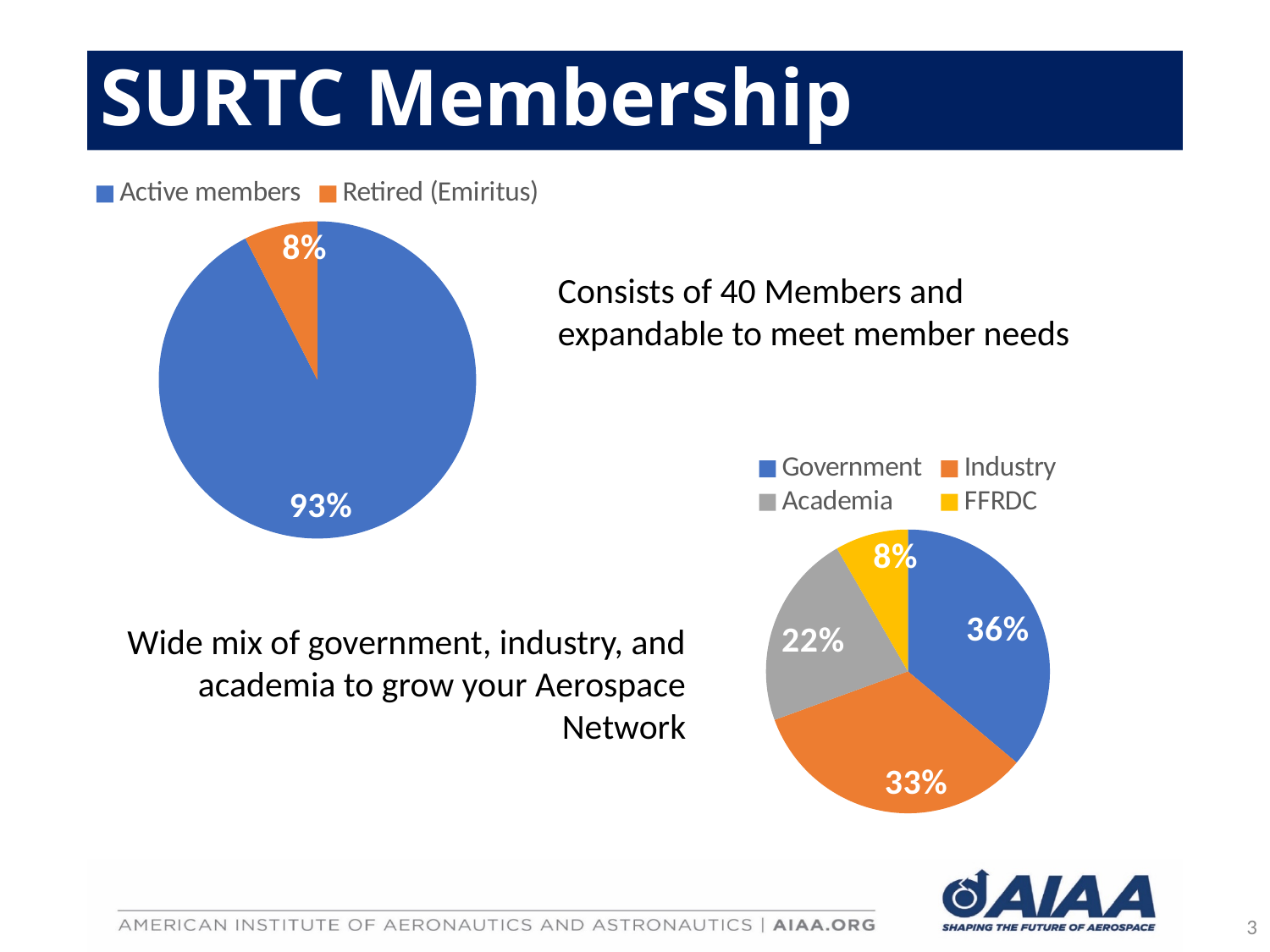
In the lower-right pie chart, what share is labelled for Industry? 33% What kind of chart is the chart in the upper left of the slide? pie chart In the lower-right pie chart, what colour is the FFRDC slice? yellow In the lower-right pie chart, what share is labelled for Academia? 22% In the lower-right pie chart, what share is labelled for Government? 36% In the upper-left pie chart, which slice is the largest? Active members In the lower-right pie chart, which slice is the smallest? FFRDC In the lower-right pie chart, what is the difference between the Government and Academia shares? 14% How many entries does the legend of the upper-left pie chart list? 2 In the upper-left pie chart, what share is labelled for Retired (Emiritus)? 8% How many slices does the lower-right pie chart have? 4 In the upper-left pie chart, what share is labelled for Active members? 93%